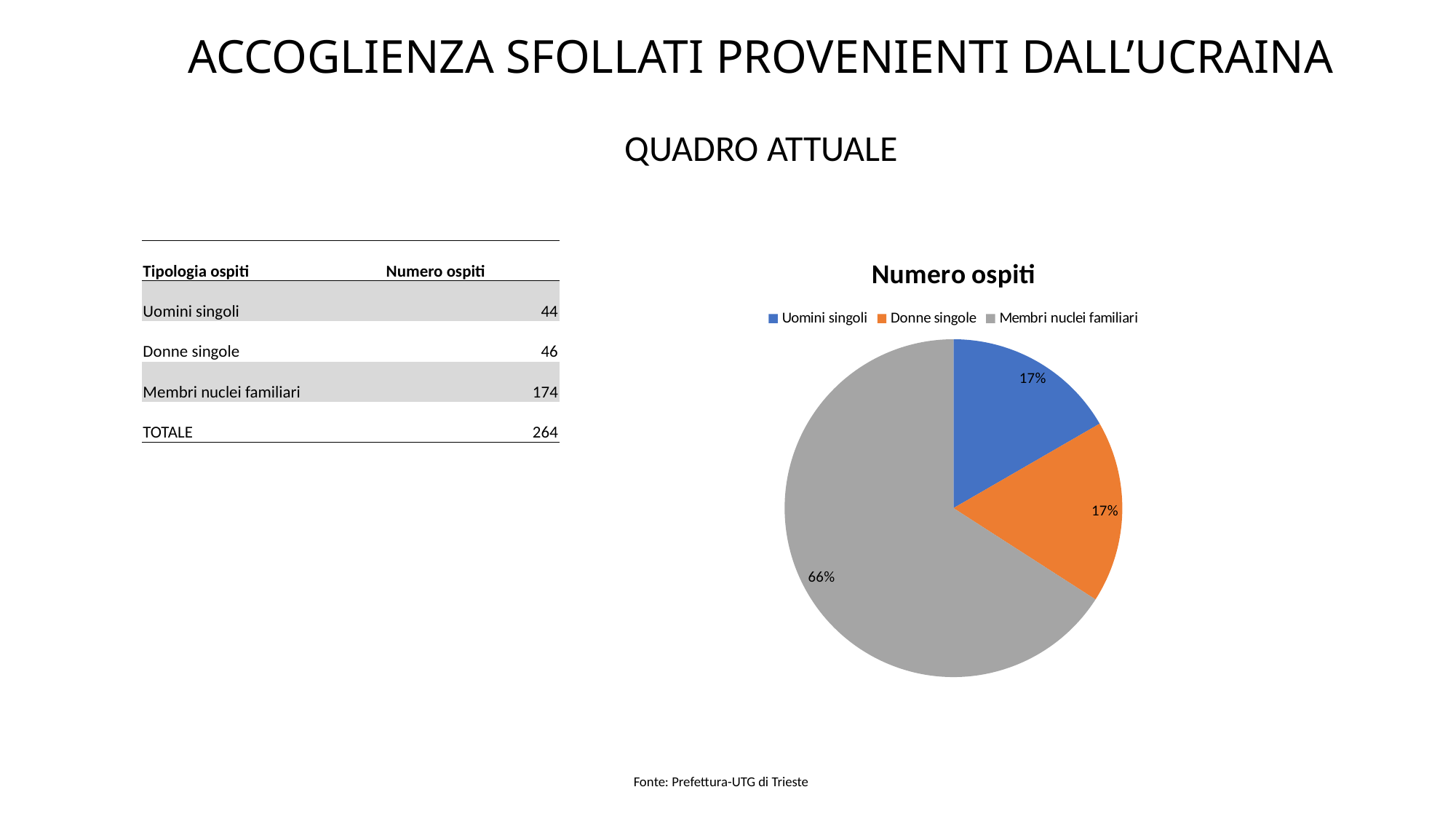
What kind of chart is shown on the slide? pie chart How many slices does the pie chart have? 3 What is the difference in percentage points between the Membri nuclei familiari slice and the Uomini singoli slice? 49 How many entries does the legend of the pie chart list? 3 Which slice is larger, Membri nuclei familiari or Donne singole? Membri nuclei familiari Which colour is used for the Donne singole slice in the pie chart? orange What share of the pie does Uomini singoli represent? 17% What share of the pie does Donne singole represent? 17% What is the title of the pie chart? Numero ospiti Which category has the largest slice in the pie chart? Membri nuclei familiari What share of the pie does Membri nuclei familiari represent? 66%